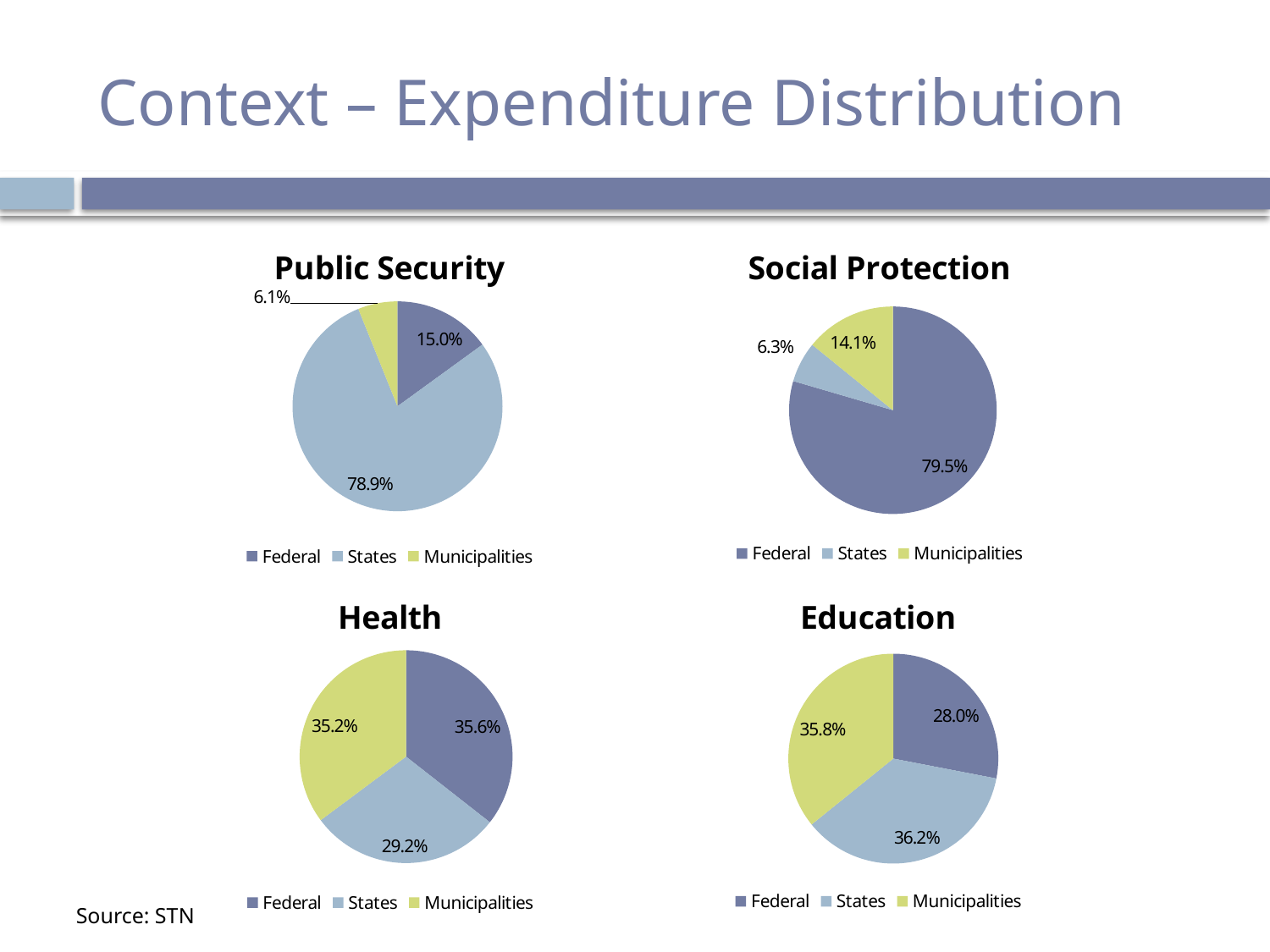
In the Education chart, which category has the smallest share? Federal In the Health chart, what is the share for States? 29.2% In the Public Security chart, what is the difference between the States share and the Federal share? 63.9% In the Health chart, what is the difference between the Federal share and the States share? 6.4% In the Public Security chart, which category has the smallest share? Municipalities In the Social Protection chart, which category has the largest share? Federal What type of chart is used for Education? Pie chart In the Public Security chart, what share of expenditure is attributed to States? 78.9% How many categories does the legend of the Health chart list? 3 In the Education chart, what is the Federal share? 28.0% In the Social Protection chart, what is the Federal share? 79.5% In the Social Protection chart, which is larger, the Municipalities share or the States share? Municipalities